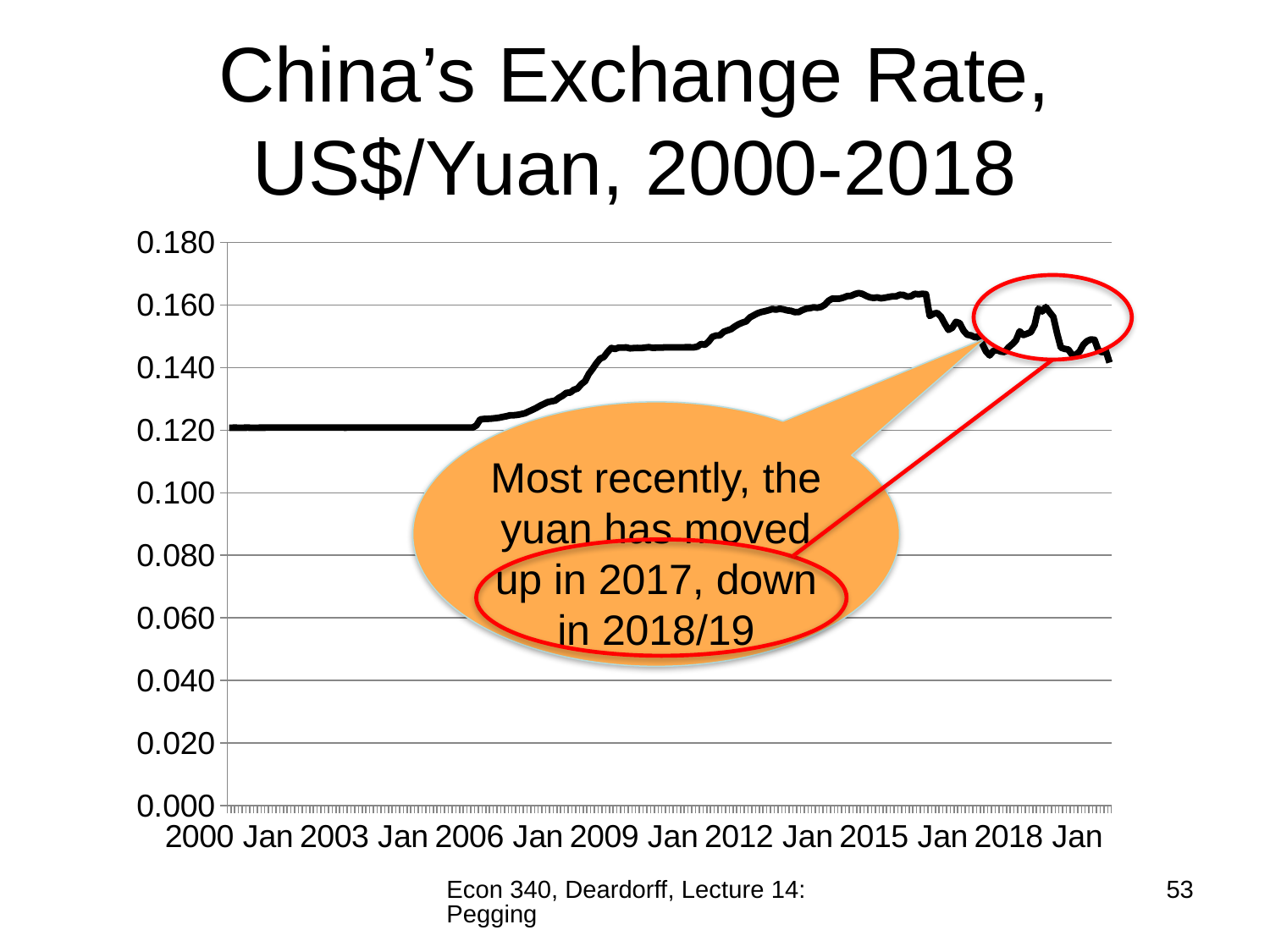
Is the exchange rate in 2012 Jan greater or less than 0.140? greater Is the exchange rate in 2018 Jan greater or less than 0.120? greater Does the exchange rate rise or fall between 2015 Jan and 2017 Jan? fall What is the title of the chart? China's Exchange Rate, US$/Yuan, 2000-2018 How many year labels are shown on the x axis? 7 Is the exchange rate in 2000 Jan greater or less than 0.140? less What kind of chart is shown on the slide? line chart Which is larger, the exchange rate in 2000 Jan or in 2012 Jan? 2012 Jan Does the exchange rate rise or fall between 2006 Jan and 2012 Jan? rise Which is larger, the exchange rate in 2006 Jan or in 2009 Jan? 2009 Jan What is the highest value labelled on the y axis? 0.180